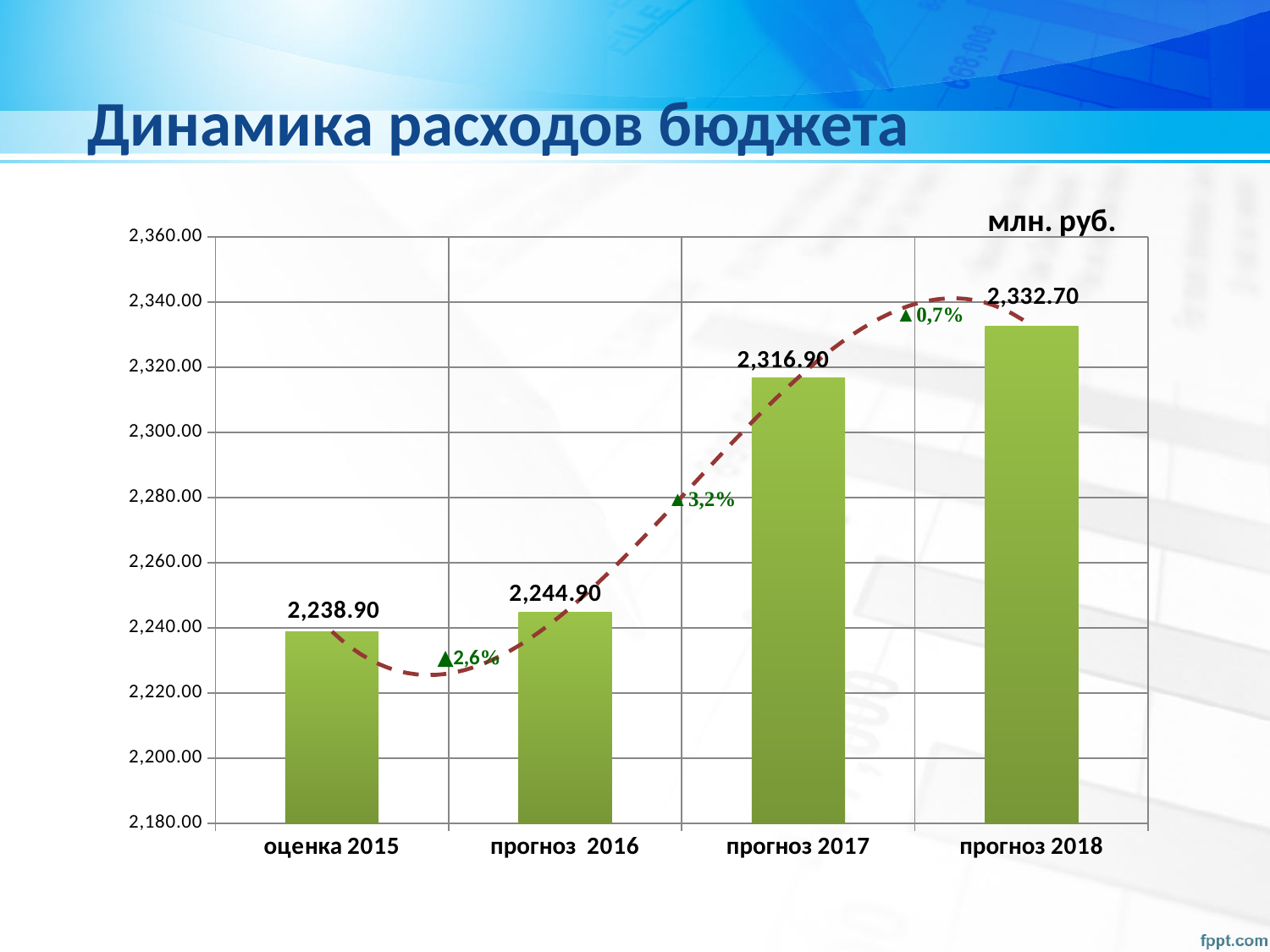
What is the value for прогноз 2018? 2,332.70 What kind of chart is shown on the slide? bar chart Which category has the lowest value? оценка 2015 What is the value for оценка 2015? 2,238.90 Which category has the highest value? прогноз 2018 Is the value for прогноз 2016 greater or less than 2,260.00? less What is the difference between the values for прогноз 2017 and прогноз 2016? 72.00 Which is larger, the value for прогноз 2016 or the value for прогноз 2017? прогноз 2017 How many categories are shown on the x axis? 4 What unit is indicated at the top right of the chart? млн. руб. What is the difference between the values for прогноз 2018 and прогноз 2017? 15.80 What is the value for прогноз 2017? 2,316.90